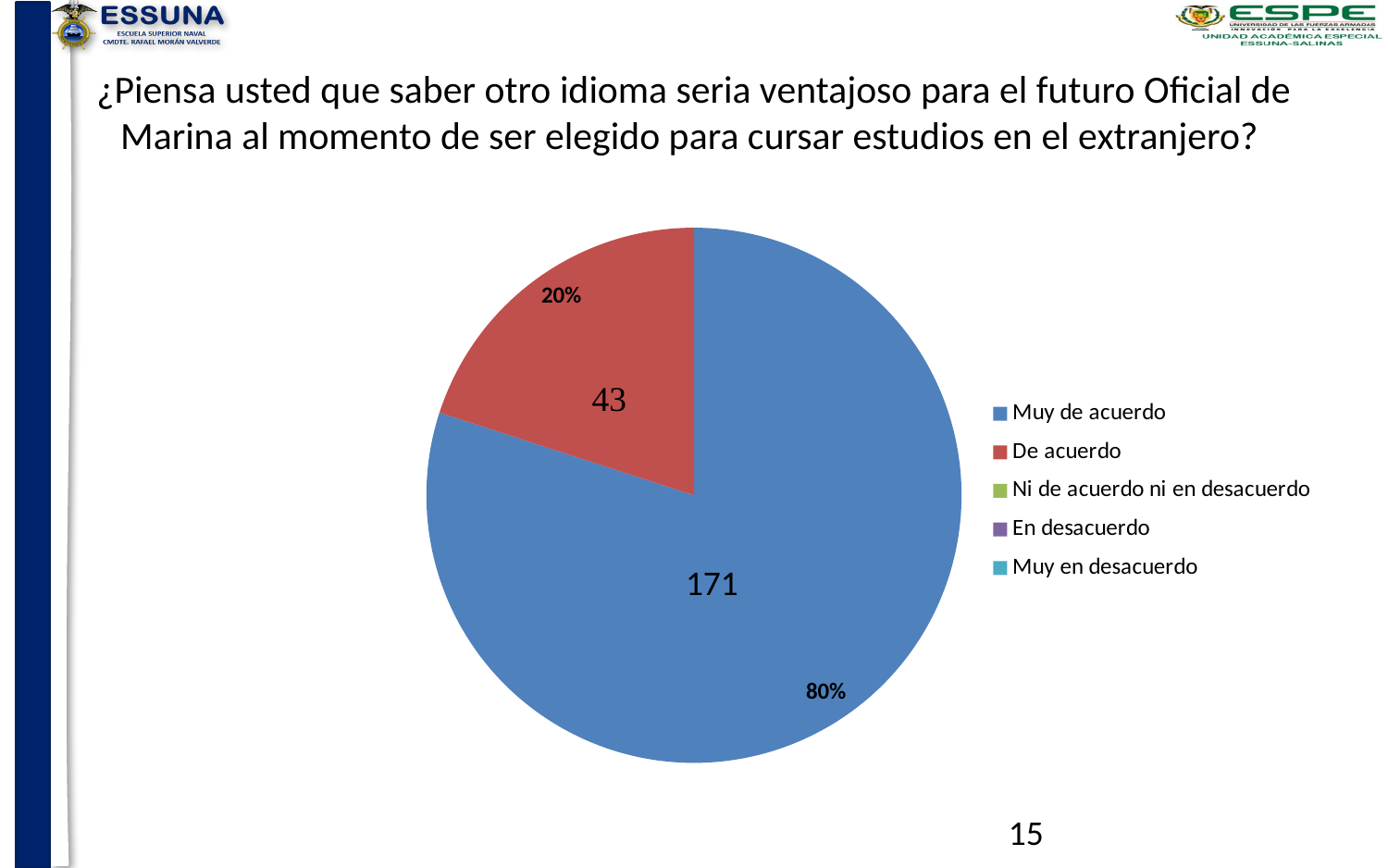
What colour is the "De acuerdo" slice? red Which category has the largest slice of the pie? Muy de acuerdo What is the value for "Muy de acuerdo"? 171 Which is larger, the value for "Muy de acuerdo" or the value for "De acuerdo"? Muy de acuerdo What is the difference between the values for "Muy de acuerdo" and "De acuerdo"? 128 What percentage share does the "Muy de acuerdo" slice have? 80% What is the value for "De acuerdo"? 43 What percentage share does the "De acuerdo" slice have? 20% What type of chart is shown on the slide? pie chart How many slices are visible in the pie chart? 2 How many entries does the legend list? 5 What is the total of the two values shown on the pie chart? 214